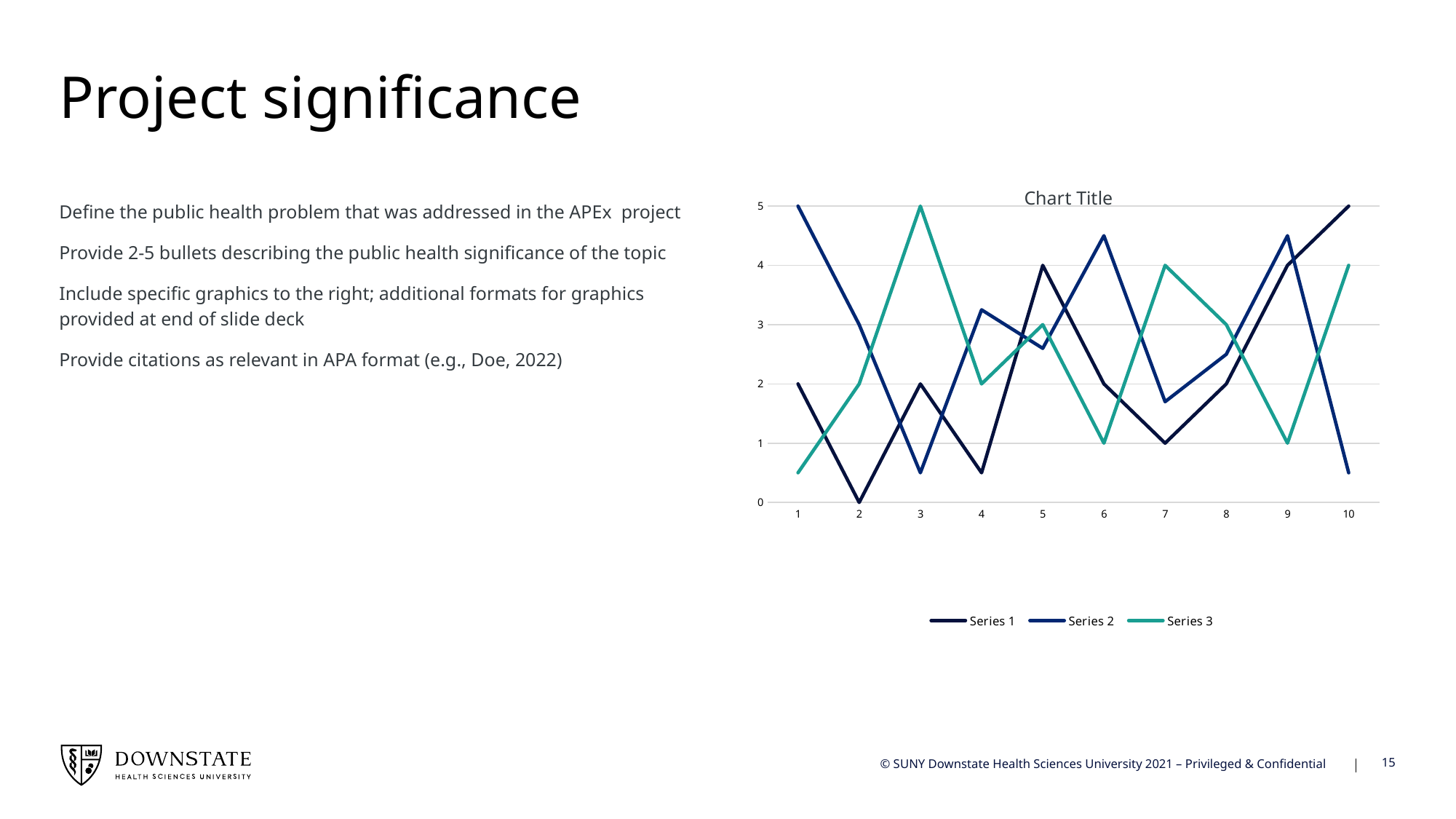
What is the value of Series 2 at x = 1? 5 What is the title of the chart? Chart Title What is the value of Series 1 at x = 2? 0 What kind of chart is shown on the slide? line chart What is the value of Series 3 at x = 3? 5 Is the value of Series 2 at x = 10 greater or less than 1? less Is the value of Series 2 at x = 9 greater or less than 4? greater What is the value of Series 1 at x = 10? 5 How many series does the legend list? 3 At x = 6, which series has the lowest value? Series 3 At x = 5, which is larger: Series 1 or Series 2? Series 1 How many points are plotted along the x axis for each series? 10